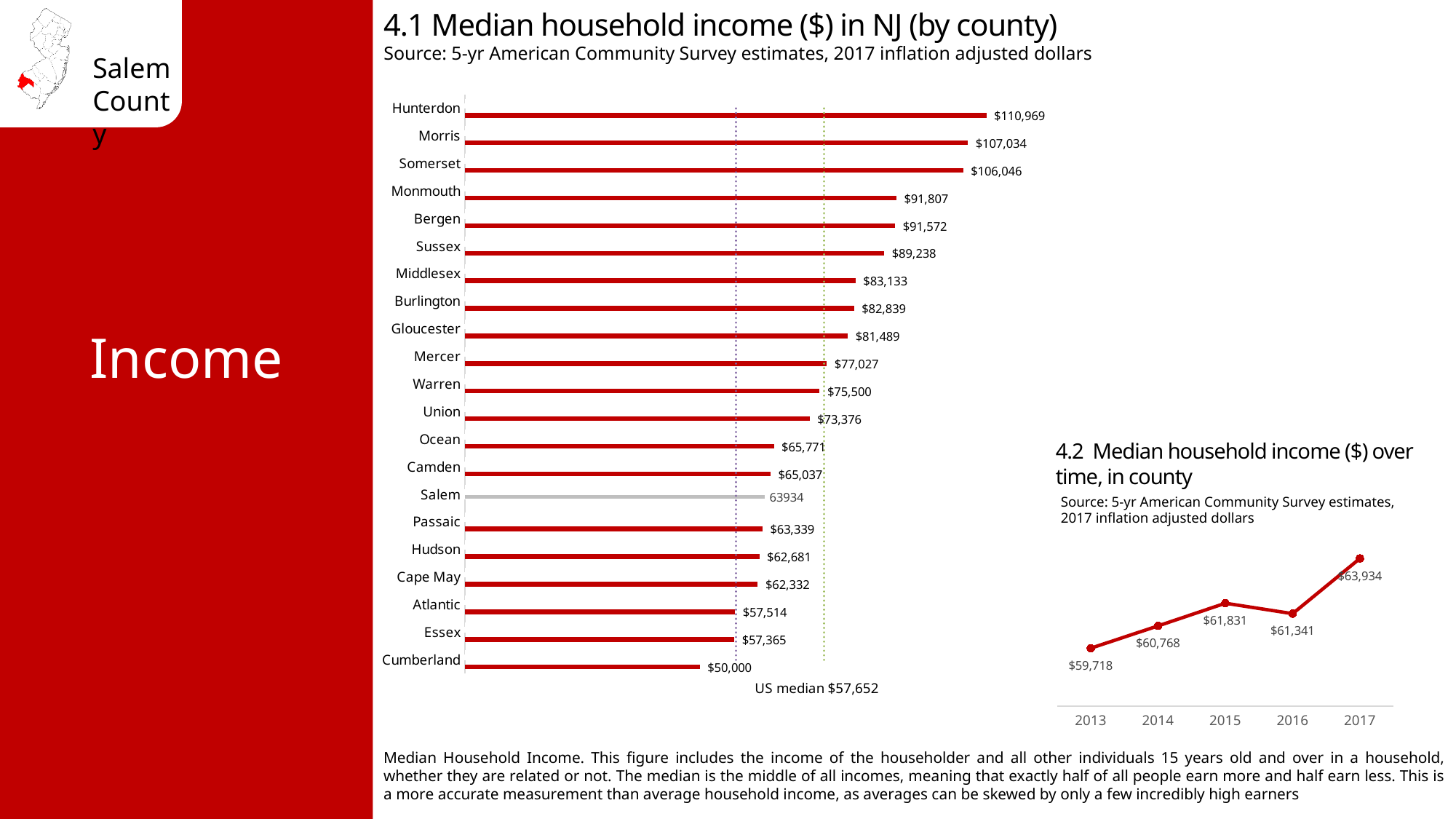
In chart 4.1, what is the difference between the median household income of Hunterdon and Cumberland? $60,969 In chart 4.1, what is the median household income for Gloucester county? $81,489 In chart 4.1, which county has the highest median household income? Hunterdon What kind of chart is chart 4.1? Bar chart In chart 4.1, what is the median household income for Salem county? 63934 In chart 4.2, what is the difference between the median household income in 2017 and in 2013? $4,216 In chart 4.1, what US median value is noted below the bars? $57,652 In chart 4.2, do the values generally rise or fall from 2013 to 2017? Rise In chart 4.1, which county has the lowest median household income? Cumberland In chart 4.1, how many counties are shown? 21 In chart 4.2, what was the median household income in 2015? $61,831 In chart 4.1, which county has a higher median household income, Mercer or Warren? Mercer